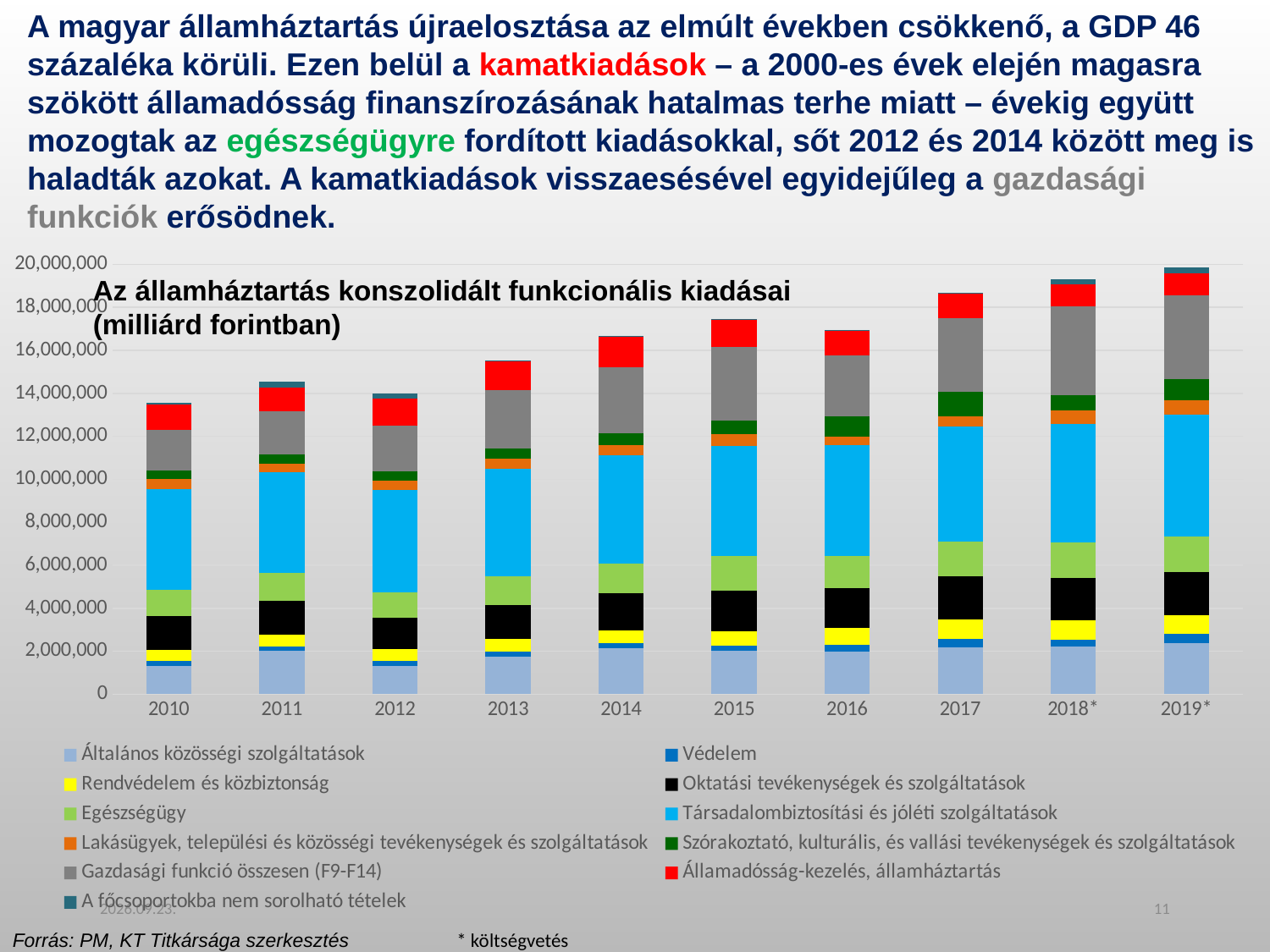
Which year has the tallest stacked bar (highest total expenditure)? 2019* What kind of chart is shown on the slide? Stacked bar chart How many series does the chart's legend list? 11 Which year has the taller stacked bar, 2015 or 2016? 2015 Which legend series is shown in red in the chart? Államadósság-kezelés, államháztartás Is the total height of the stacked bar for 2017 greater or less than 18,000,000? greater How many years (categories) are shown along the x axis of the chart? 10 Do the total stacked bar heights generally rise or fall from 2010 to 2019*? rise Is the total height of the stacked bar for 2010 greater or less than 14,000,000? less Is the total height of the stacked bar for 2014 greater or less than 16,000,000? greater What is the title of the chart? Az államháztartás konszolidált funkcionális kiadásai (milliárd forintban)